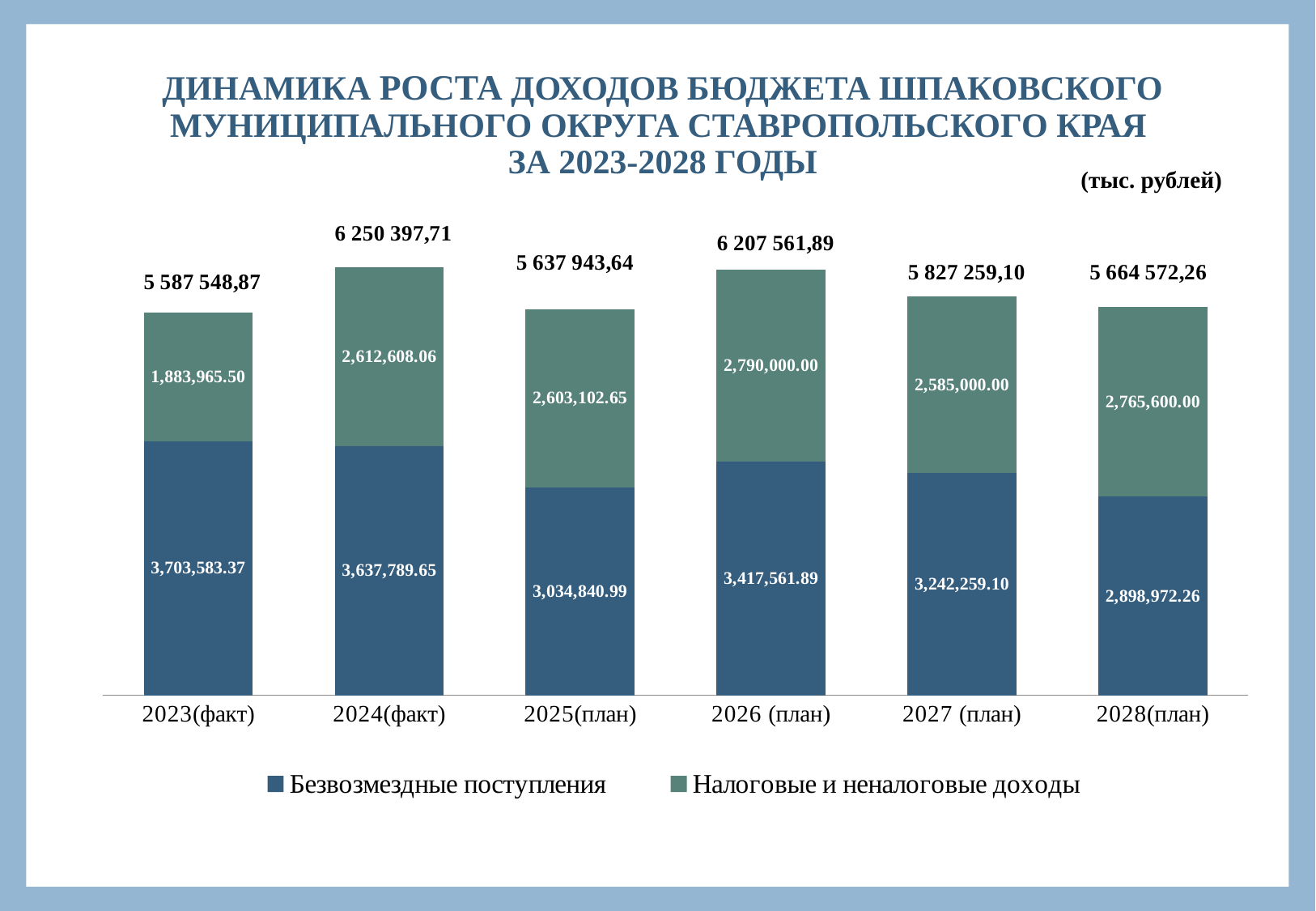
Which year has the highest total budget income? 2024(факт) What kind of chart is shown on the slide? Stacked bar chart Which year has the lowest total budget income? 2023(факт) In which year is Налоговые и неналоговые доходы the lowest? 2023(факт) For 2025(план), which is larger: Безвозмездные поступления or Налоговые и неналоговые доходы? Безвозмездные поступления What is the difference between Налоговые и неналоговые доходы in 2026 (план) and 2027 (план)? 205,000.00 What is the difference between Безвозмездные поступления in 2023(факт) and 2024(факт)? 65,793.72 What is the total printed above the stacked bar for 2024(факт)? 6 250 397,71 What is the value of Налоговые и неналоговые доходы for 2026 (план)? 2,790,000.00 How many years are shown on the x axis? 6 What is the value of Безвозмездные поступления for 2023(факт)? 3,703,583.37 How many series does the legend list? 2